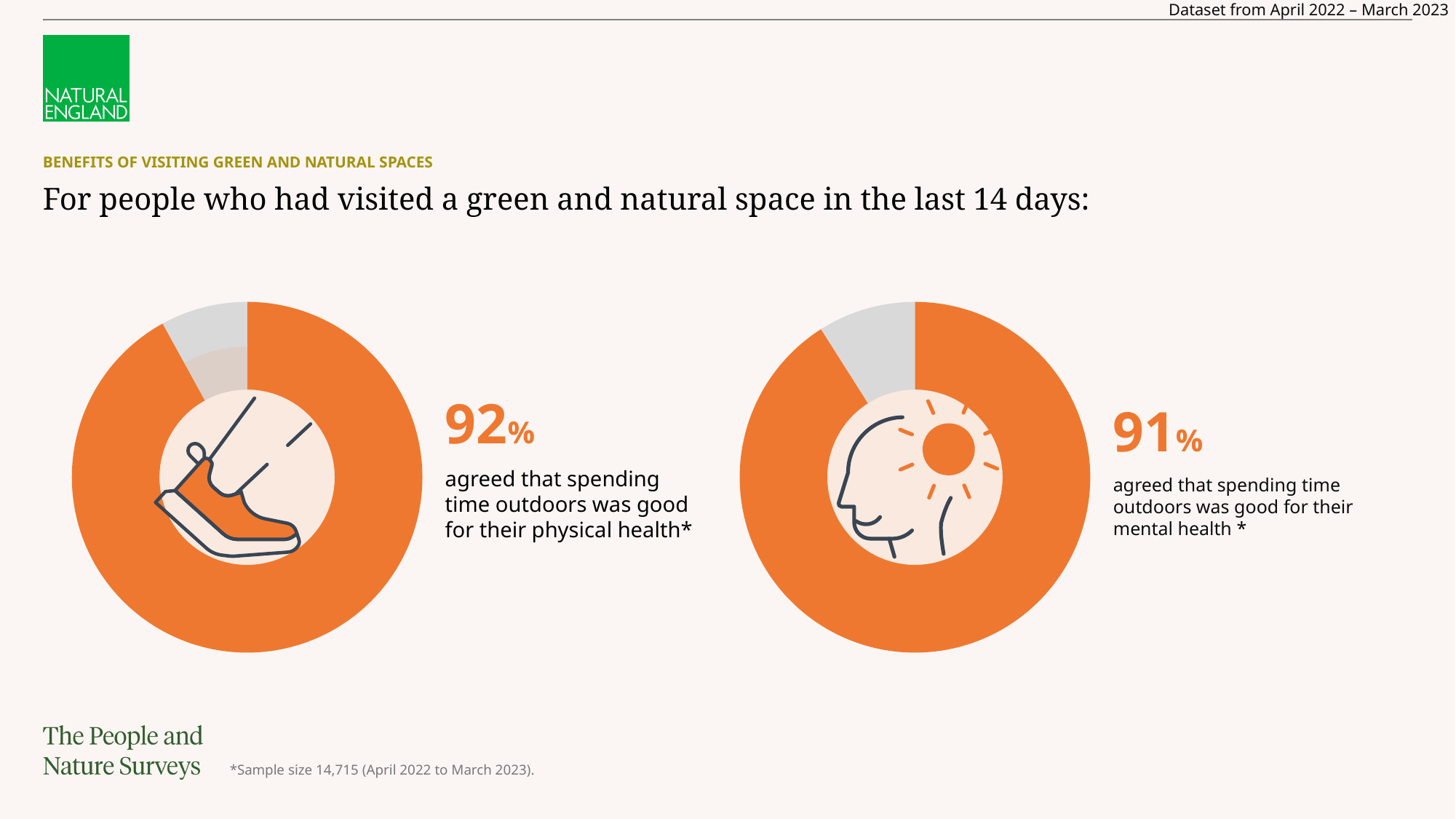
Which is larger: the share agreeing outdoors was good for physical health (left chart) or for mental health (right chart)? physical health What colour is used for the segment representing people who agreed in both donut charts? orange Is the value shown on the right chart for mental health greater or less than 90%? greater On the right chart, what share of the donut is not coloured orange (the remainder after the 91% who agreed)? 9% What is the sample size stated in the footnote for the charts on the slide? 14,715 What kind of chart is used on the left of the slide to show the physical health figure? pie chart (donut) What is the difference in percentage points between the physical health figure on the left chart and the mental health figure on the right chart? 1 On the left chart, what share of the donut is not coloured orange (the remainder after the 92% who agreed)? 8% How many segments does each donut chart on the slide have? 2 On the left chart, what percentage agreed that spending time outdoors was good for their physical health? 92% On the right chart, what percentage agreed that spending time outdoors was good for their mental health? 91%